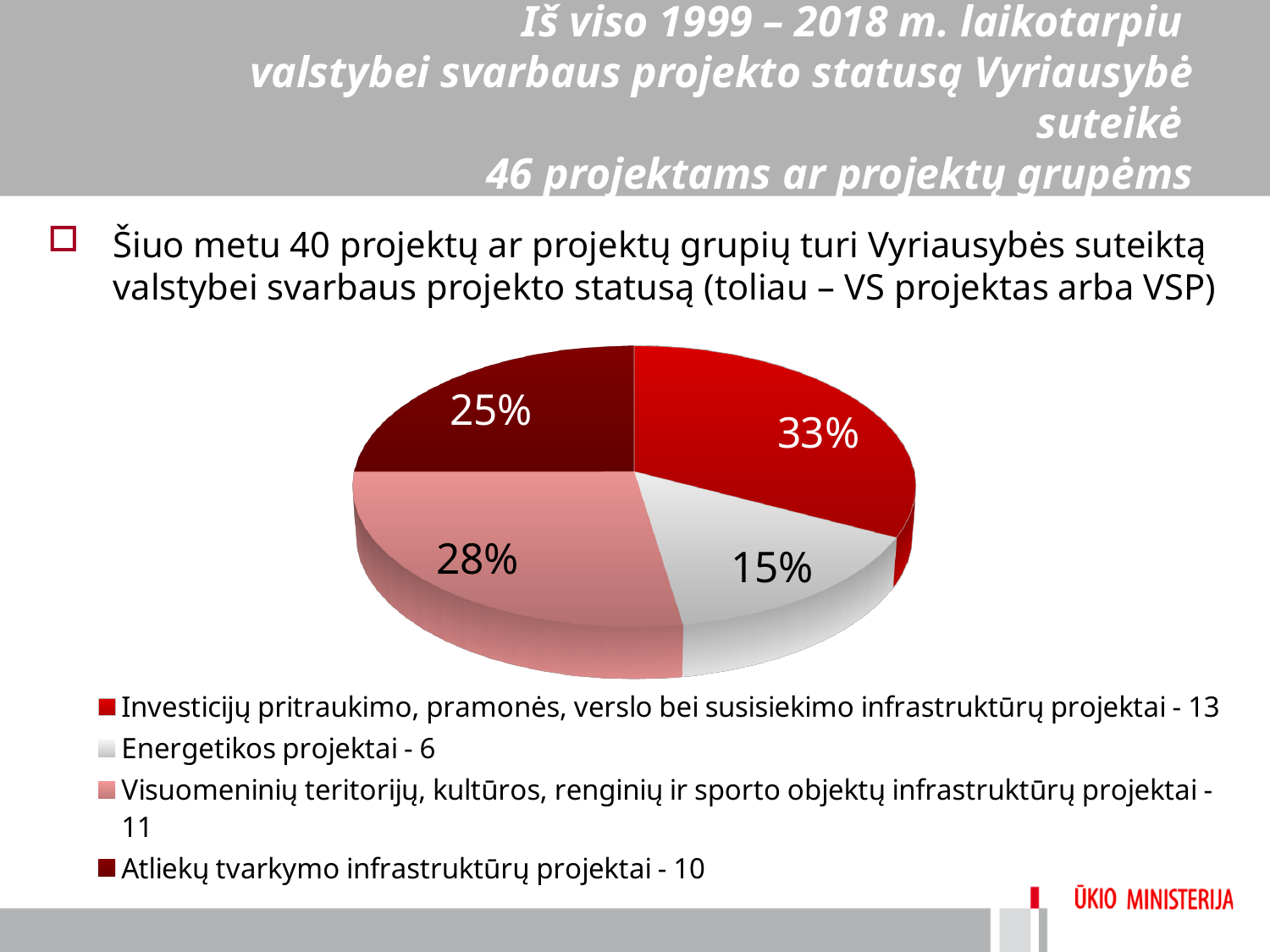
Which slice is larger: 'Visuomeninių teritorijų...' projects or 'Atliekų tvarkymo...' projects? Visuomeninių teritorijų, kultūros, renginių ir sporto objektų infrastruktūrų projektai - 11 How many projects does the legend list for 'Atliekų tvarkymo infrastruktūrų projektai'? 10 What percentage share is shown for the slice 'Energetikos projektai - 6'? 15% What kind of chart is shown on the slide? pie chart Which category has the smallest share of the pie? Energetikos projektai - 6 What is the difference in percentage points between the 'Investicijų pritraukimo...' slice (33%) and the 'Energetikos projektai' slice (15%)? 18 What percentage share is shown for the slice 'Visuomeninių teritorijų, kultūros, renginių ir sporto objektų infrastruktūrų projektai - 11'? 28% What percentage share is shown for the slice 'Atliekų tvarkymo infrastruktūrų projektai - 10'? 25% What percentage share is shown for the slice 'Investicijų pritraukimo, pramonės, verslo bei susisiekimo infrastruktūrų projektai - 13'? 33% What colour is the slice for 'Energetikos projektai - 6'? grey Which category has the largest share of the pie? Investicijų pritraukimo, pramonės, verslo bei susisiekimo infrastruktūrų projektai - 13 How many slices does the pie chart have? 4